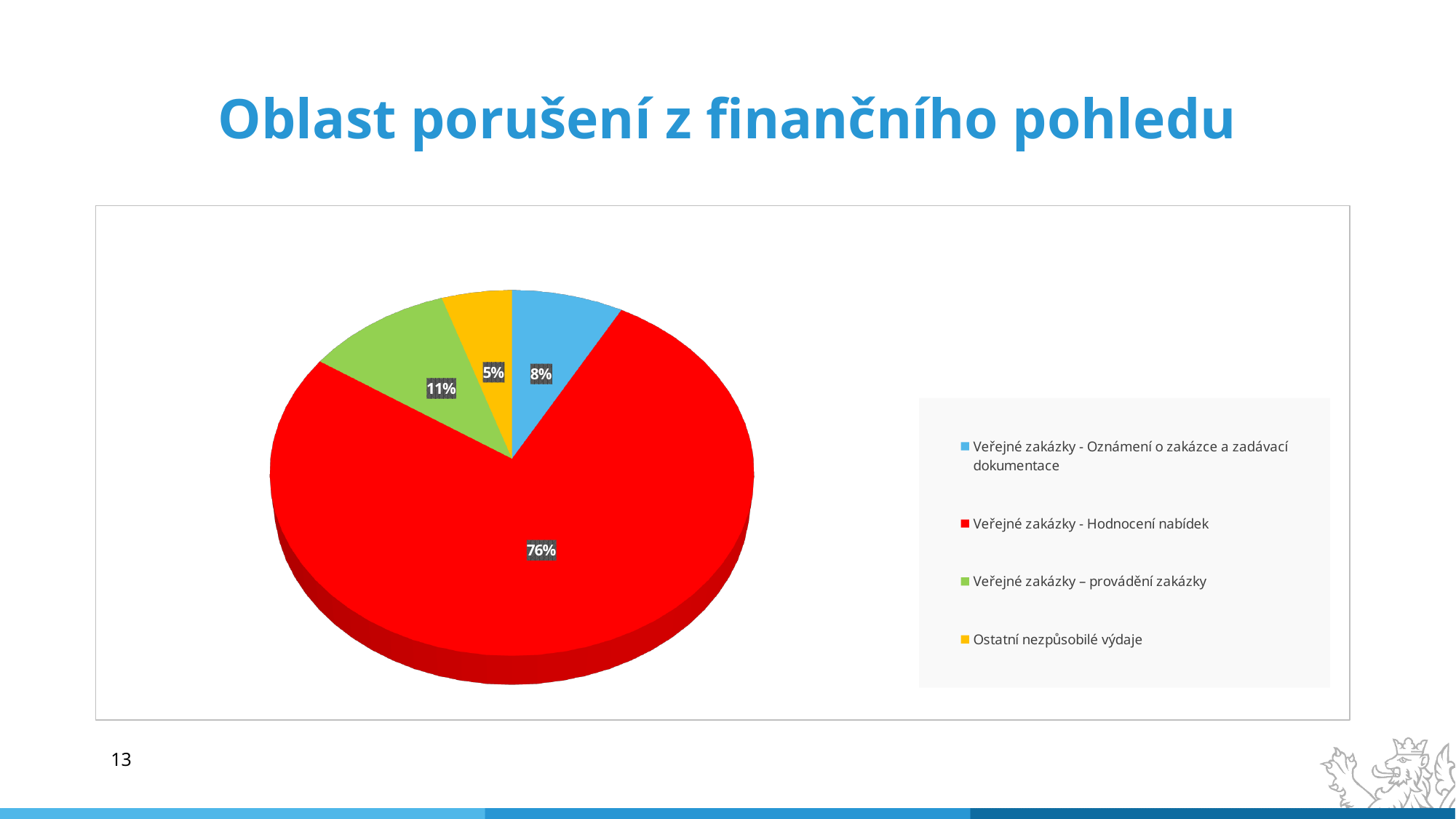
What colour is the slice for "Ostatní nezpůsobilé výdaje"? Yellow What kind of chart is shown on the slide? Pie chart Which category has the largest slice of the pie? Veřejné zakázky - Hodnocení nabídek What share of the pie does "Veřejné zakázky – provádění zakázky" represent? 11% Which is larger: the slice for "Veřejné zakázky – provádění zakázky" or the slice for "Veřejné zakázky - Oznámení o zakázce a zadávací dokumentace"? Veřejné zakázky – provádění zakázky What is the difference in percentage points between "Veřejné zakázky - Hodnocení nabídek" and "Veřejné zakázky – provádění zakázky"? 65 Which category has the smallest slice of the pie? Ostatní nezpůsobilé výdaje What is the title of the slide containing the chart? Oblast porušení z finančního pohledu How many categories are shown in the pie chart? 4 What share of the pie does "Ostatní nezpůsobilé výdaje" represent? 5% What share of the pie does "Veřejné zakázky - Oznámení o zakázce a zadávací dokumentace" represent? 8%